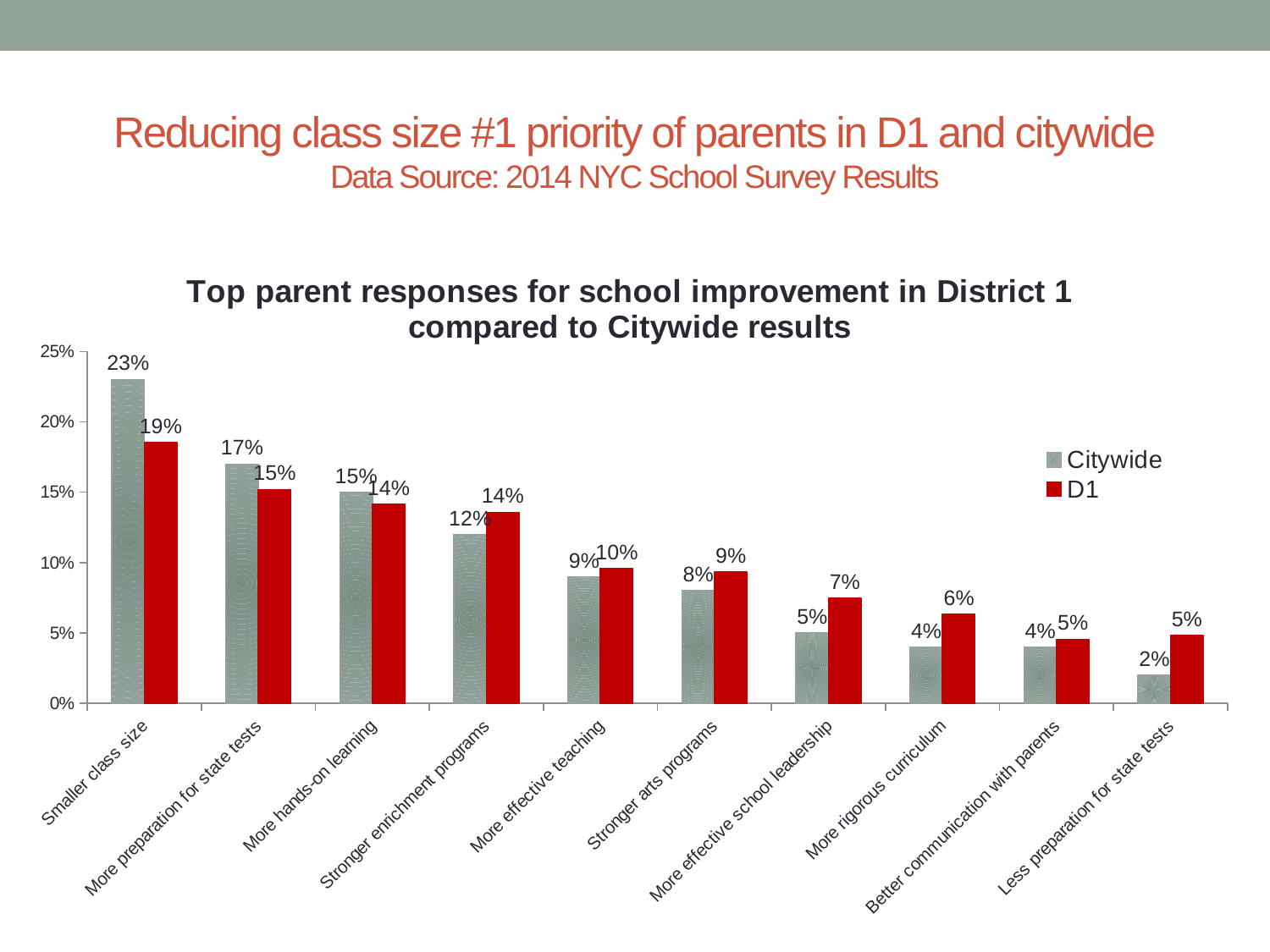
What kind of chart is shown on the slide? Bar chart What is the D1 value for Smaller class size? 19% Do the Citywide values rise or fall from left to right along the x axis? Fall How many series does the legend list? 2 What is the Citywide value for Less preparation for state tests? 2% What is the difference between the Citywide and D1 values for Smaller class size? 4% Which category has the highest Citywide value? Smaller class size How many categories are shown on the x axis? 10 Which category has the lowest Citywide value? Less preparation for state tests What is the Citywide value for Smaller class size? 23% What is the D1 value for Stronger enrichment programs? 14% For More effective school leadership, which is larger, the Citywide value or the D1 value? D1